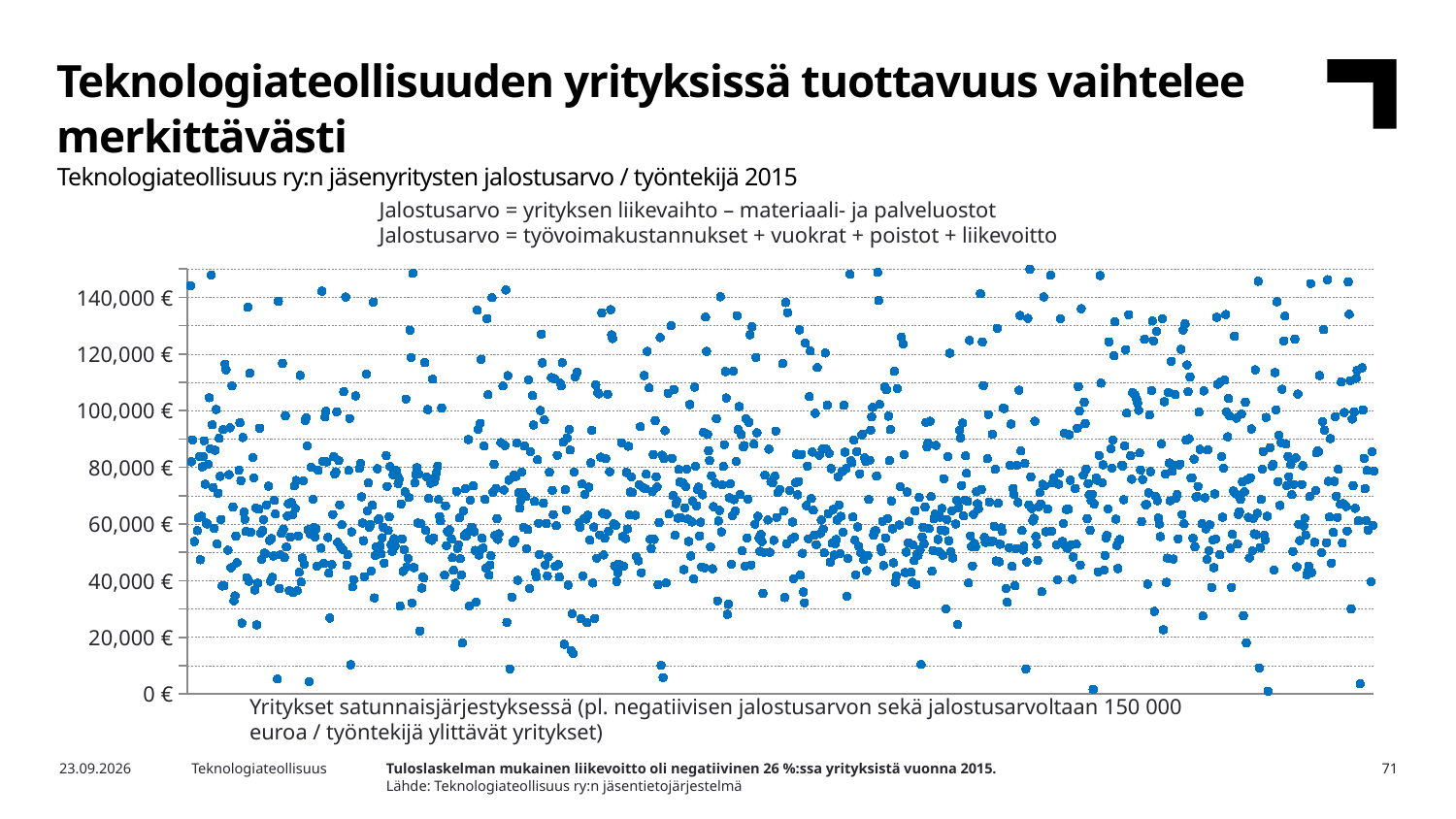
Which year does the chart's data refer to, according to the chart title? 2015 Are most of the plotted points above or below 100,000 € on the y axis? below What is the lowest labelled tick on the y axis of the chart? 0 € What kind of chart is shown on the slide? scatter chart What is the highest labelled tick on the y axis of the chart? 140,000 € Are there any plotted points below the 20,000 € line on the y axis? yes